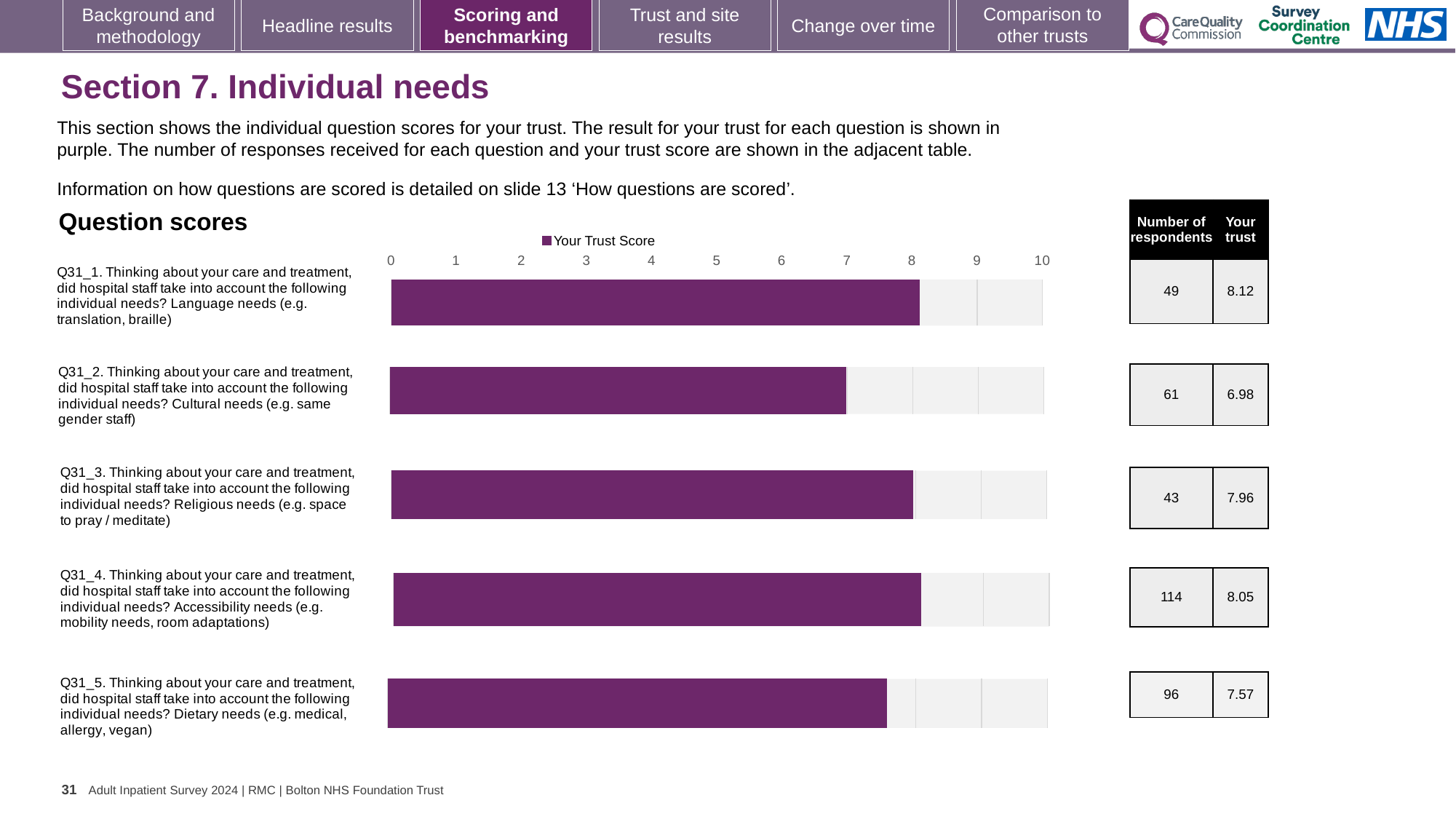
Which question has the highest trust score? Q31_1 (Language needs) How many questions are plotted in the chart? 5 What type of chart is shown? Bar chart Is the trust score for Q31_2 (Cultural needs) greater or less than 8? less Which question has the lowest trust score? Q31_2 (Cultural needs) What is the name of the series shown in the chart legend? Your Trust Score What is the trust score for Q31_5 (Dietary needs)? 7.57 What is the trust score for Q31_2 (Cultural needs)? 6.98 How many series does the chart legend list? 1 What is the trust score for Q31_1 (Language needs)? 8.12 Which has a higher trust score, Q31_3 (Religious needs) or Q31_5 (Dietary needs)? Q31_3 (Religious needs) What is the difference between the trust scores for Q31_1 and Q31_2? 1.14